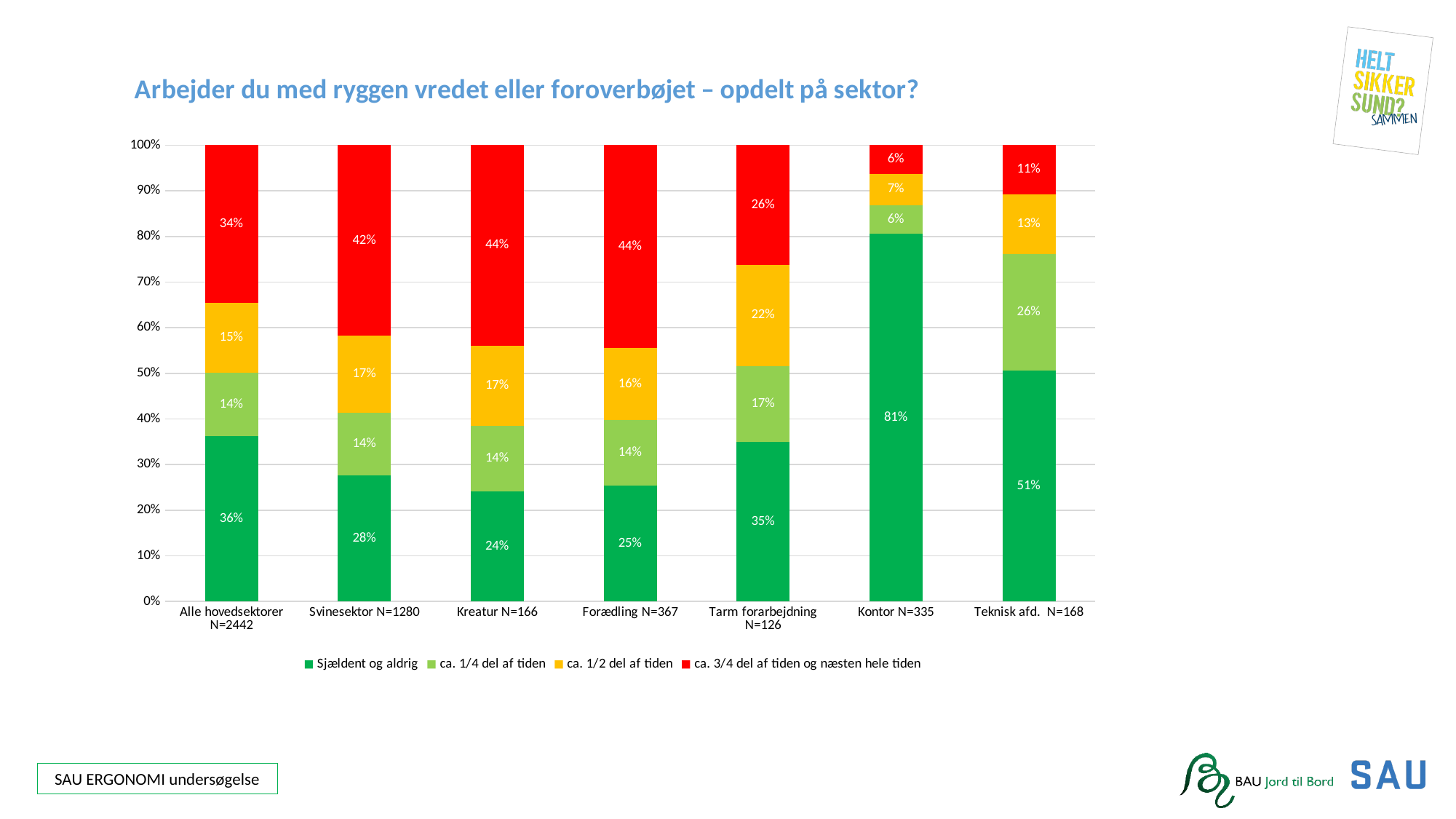
How many series does the legend list? 4 What is the difference between the "Sjældent og aldrig" values for Kontor N=335 and Teknisk afd. N=168? 30% What is the value for "Sjældent og aldrig" in the Kontor N=335 category? 81% What is the value for "ca. 3/4 del af tiden og næsten hele tiden" in the Svinesektor N=1280 category? 42% Which category has the lowest value for "ca. 3/4 del af tiden og næsten hele tiden"? Kontor N=335 How many categories are shown on the x axis? 7 What kind of chart is shown on the slide? Stacked bar chart What is the value for "ca. 1/4 del af tiden" in the Teknisk afd. N=168 category? 26% Which category has the highest value for "Sjældent og aldrig"? Kontor N=335 What is the value for "ca. 1/2 del af tiden" in the Tarm forarbejdning N=126 category? 22% What colour represents "ca. 1/2 del af tiden" in the chart? Yellow Which is larger: the "ca. 3/4 del af tiden og næsten hele tiden" value for Alle hovedsektorer N=2442 or for Tarm forarbejdning N=126? Alle hovedsektorer N=2442